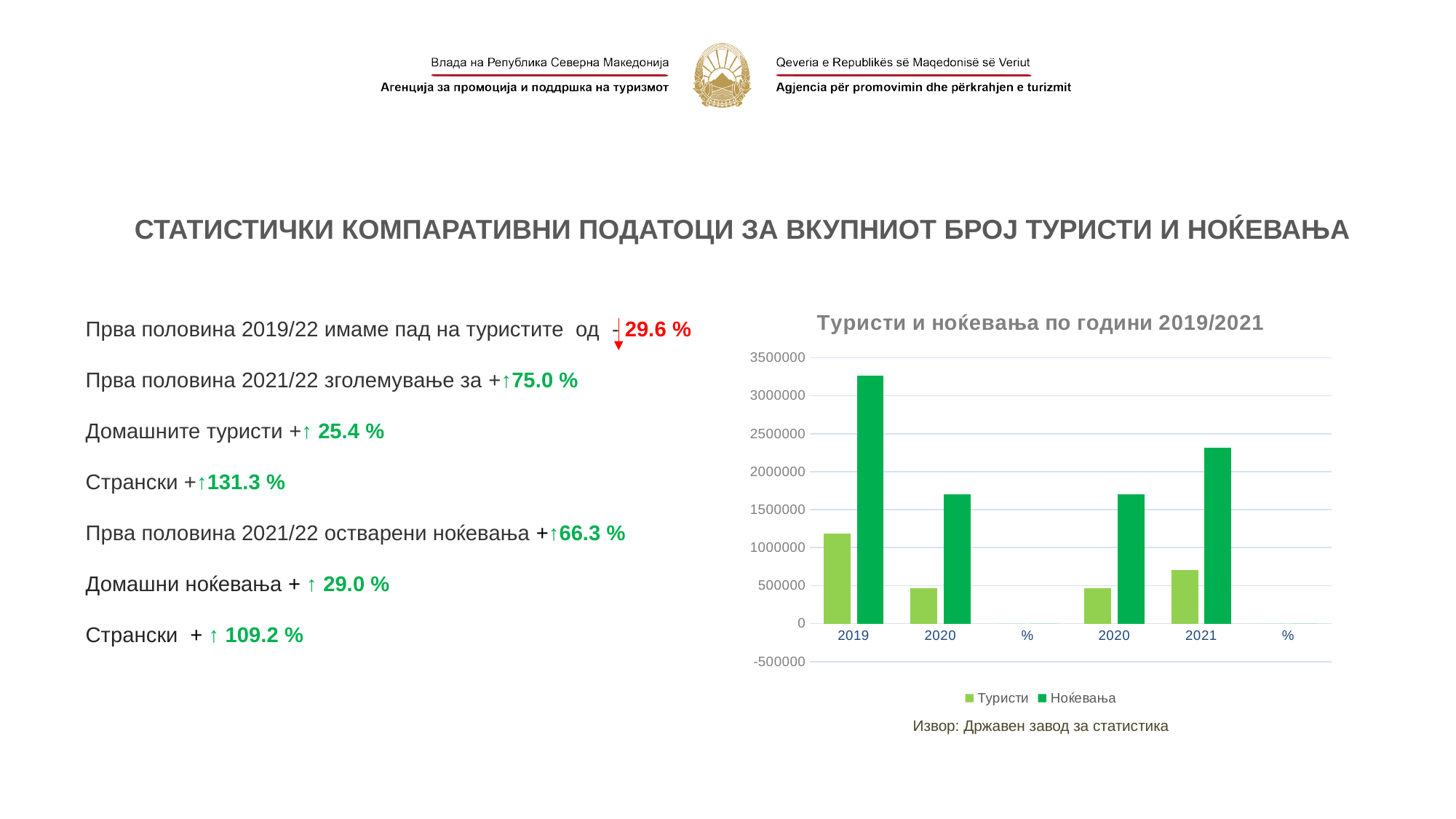
Do the Ноќевања values rise or fall from 2020 to 2021? rise In which year is the Туристи bar the highest? 2019 In which year is the Ноќевања bar the highest? 2019 How many series does the chart legend list? 2 What is the title of the chart? Туристи и ноќевања по години 2019/2021 Is the Ноќевања value for 2021 greater or less than 2000000? greater Which is larger, the Ноќевања value for 2019 or for 2021? 2019 What kind of chart is shown on the slide? bar chart Is the Туристи value for 2019 greater or less than 1000000? greater What are the two series named in the chart legend? Туристи and Ноќевања Is the Туристи value for 2021 greater or less than 1000000? less